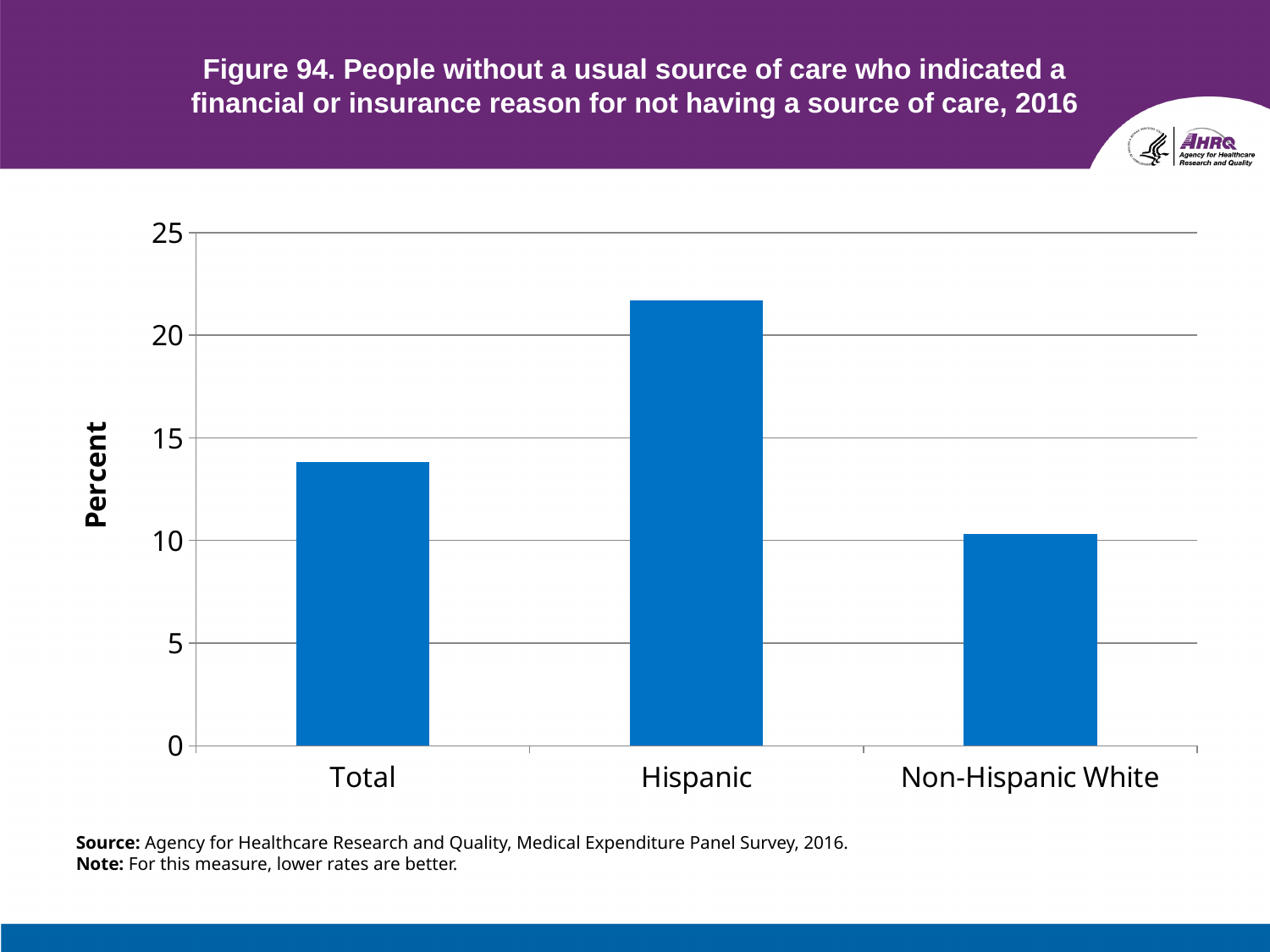
What kind of chart is shown on the slide? bar chart Is the value for Total greater or less than 10? greater How many categories are shown on the x axis? 3 What is the maximum value shown on the vertical axis? 25 Which is larger, the value for Total or the value for Non-Hispanic White? Total Which is larger, the value for Hispanic or the value for Non-Hispanic White? Hispanic Which category has the highest value? Hispanic Which category has the lowest value? Non-Hispanic White What is the label of the vertical axis? Percent Is the value for Total greater or less than 15? less Is the value for Hispanic greater or less than 20? greater